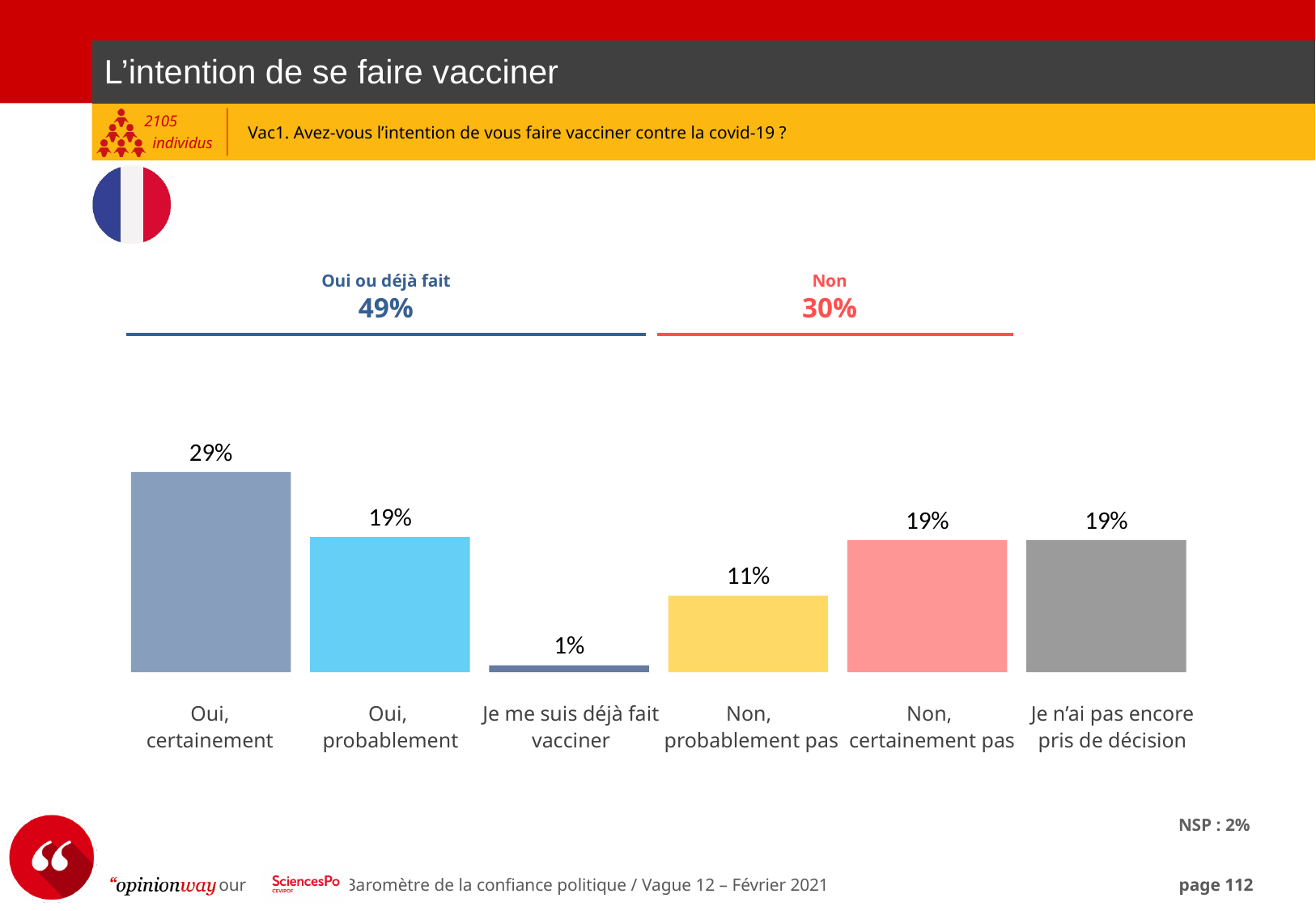
What is the value for "Non, probablement pas"? 11% What is the value for "Oui, certainement"? 29% What is the difference between "Non, certainement pas" and "Non, probablement pas"? 8% Which category has the lowest value? Je me suis déjà fait vacciner Which category has the highest value? Oui, certainement What kind of chart is shown on the slide? Bar chart What combined percentage is shown for the "Oui ou déjà fait" group? 49% What is the difference between "Oui, certainement" and "Oui, probablement"? 10% How many categories are shown in the bar chart? 6 What is the value for "Je n'ai pas encore pris de décision"? 19% What is the value for "Je me suis déjà fait vacciner"? 1% Which is larger, "Oui, certainement" or "Non, probablement pas"? Oui, certainement